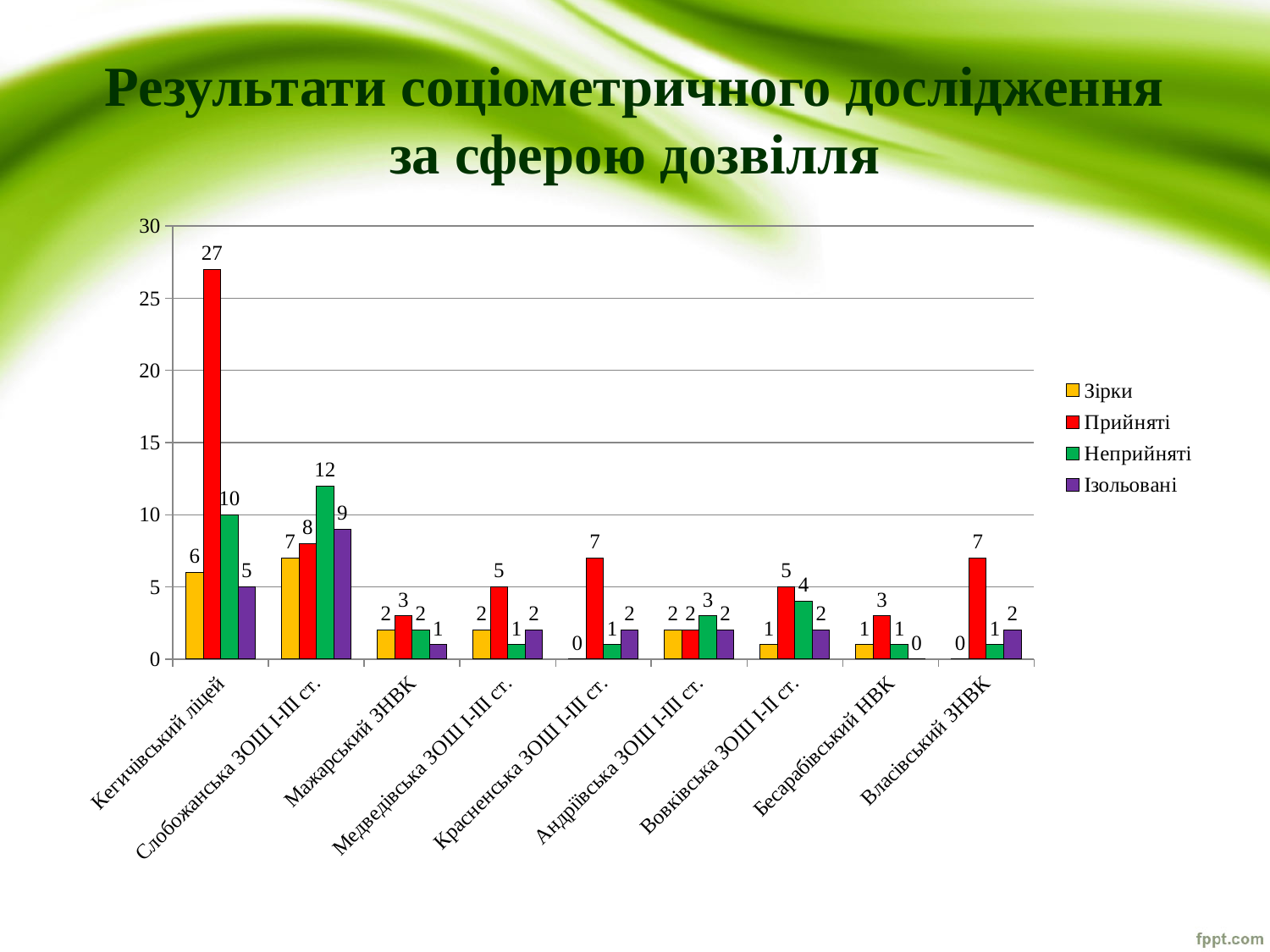
How many schools (categories) are shown on the x axis? 9 What is the value of Ізольовані for Бесарабівський НВК? 0 Which is larger for Вовківська ЗОШ І-ІІ ст.: Прийняті or Неприйняті? Прийняті What type of chart is shown on the slide? bar chart Which school has the highest value for Прийняті? Кегичівський ліцей Which school has the lowest value for Ізольовані? Бесарабівський НВК How many series does the legend list? 4 Is the value of Прийняті for Кегичівський ліцей greater or less than 25? greater What is the value of Неприйняті for Слобожанська ЗОШ І-ІІІ ст.? 12 What is the difference between Прийняті and Зірки for Кегичівський ліцей? 21 What is the title of the chart on the slide? Результати соціометричного дослідження за сферою дозвілля What is the value of Прийняті for Кегичівський ліцей? 27